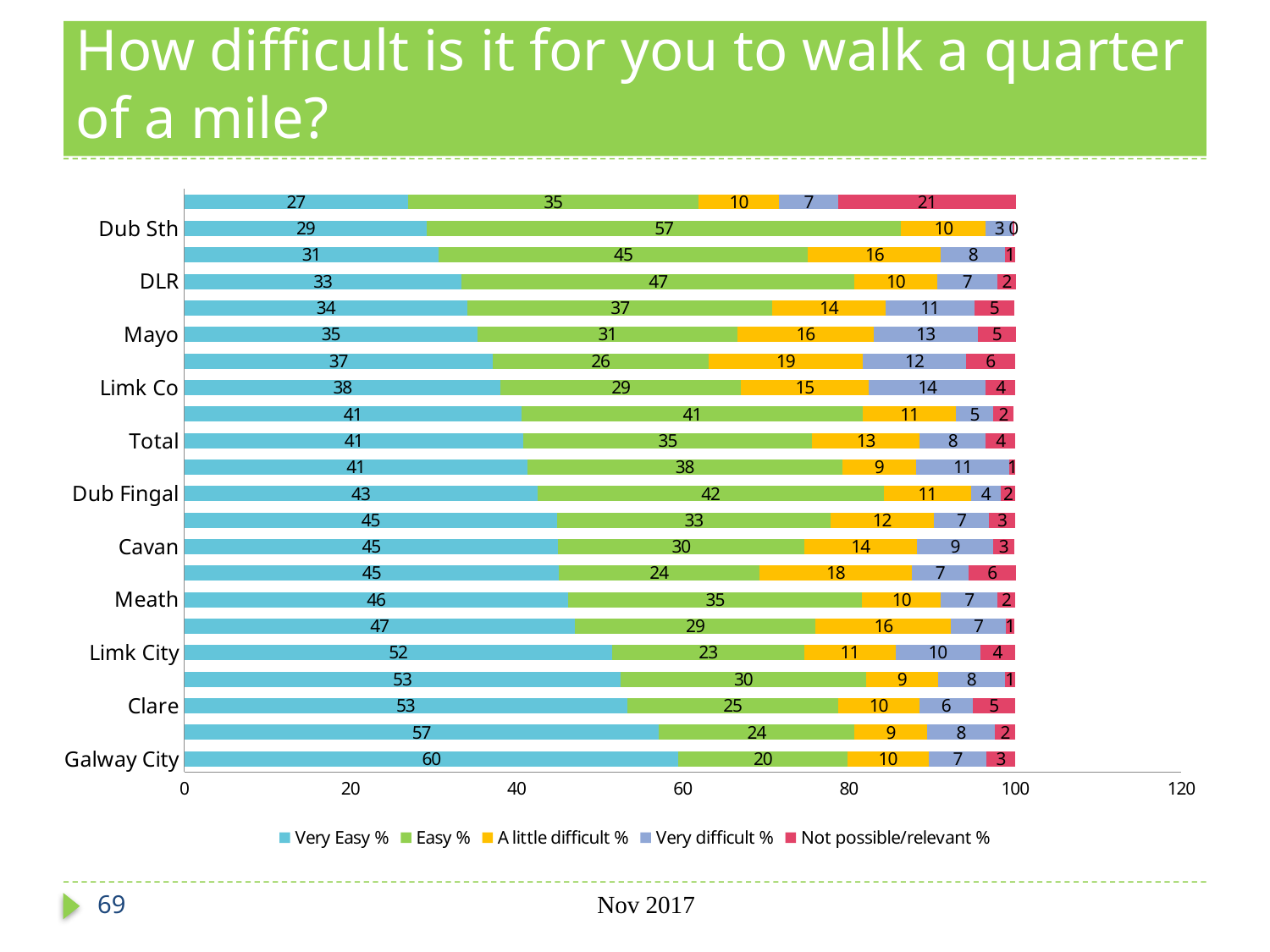
What is the last entry in the legend? Not possible/relevant % What kind of chart is shown on the slide? stacked bar chart What is the difference between the Very Easy % values for Galway City and Total? 19 What is the Very difficult % value for Limk Co? 14 What is the Easy % value for Dub Sth? 57 Among the labelled categories, which has the highest Very Easy % value? Galway City How many series does the legend list? 5 What is the A little difficult % value for Mayo? 16 Among the labelled categories, which has the lowest Very Easy % value? Dub Sth Which has a larger Easy % value, DLR or Cavan? DLR What is the Not possible/relevant % value for Clare? 5 What is the Very Easy % value for Galway City? 60